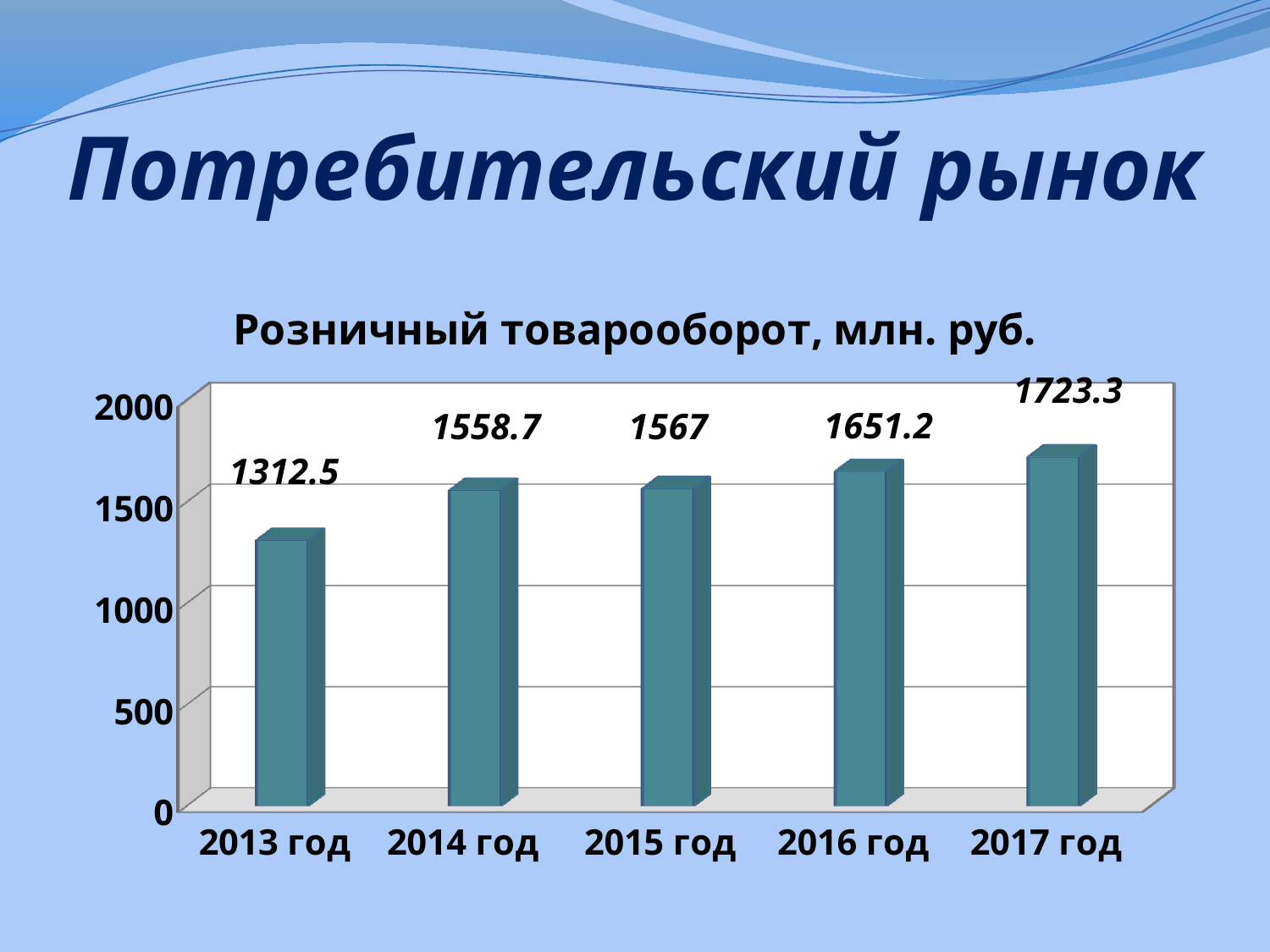
What is the difference between the values for 2016 год and 2014 год? 92.5 Do the values rise or fall from 2013 год to 2017 год? rise Which is larger, the value for 2014 год or the value for 2016 год? 2016 год How many years are shown on the chart? 5 Which year has the highest retail turnover? 2017 год What kind of chart is shown on the slide? bar chart What is the difference between the values for 2017 год and 2013 год? 410.8 What is the value shown for 2015 год? 1567 Which year has the lowest retail turnover? 2013 год What is the retail turnover value for 2013 год? 1312.5 Is the value for 2013 год greater or less than 1500? less What is the retail turnover value for 2016 год? 1651.2